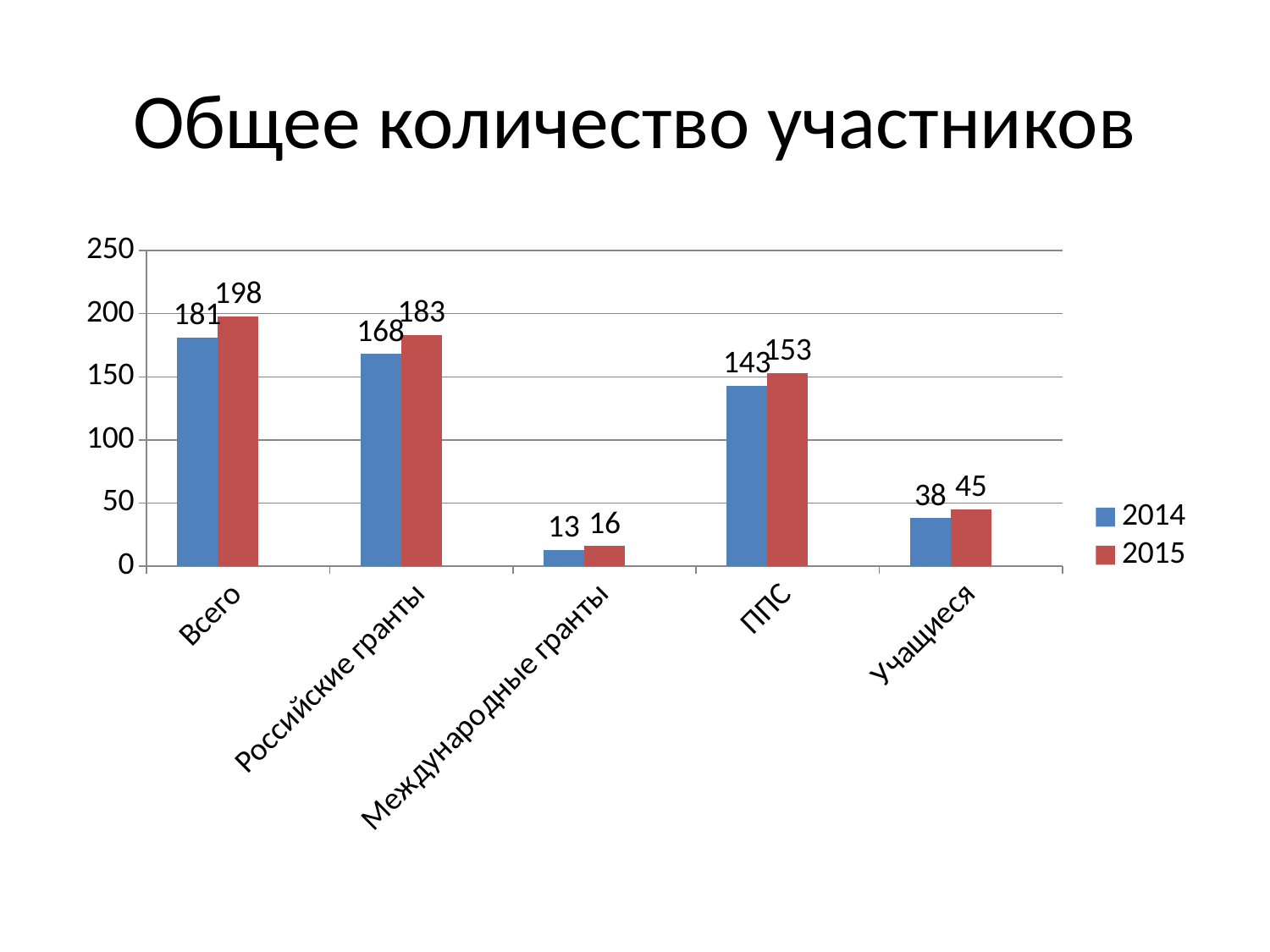
What is the difference between the 2015 and 2014 values for Всего? 17 How many categories are shown on the x axis? 5 What is the value for Международные гранты in 2014? 13 Which category has the lowest value in 2015? Международные гранты Which is larger for ППС: the 2014 value or the 2015 value? 2015 What is the difference between the 2015 and 2014 values for Российские гранты? 15 What type of chart is shown on the slide? Bar chart How many series does the legend list? 2 What is the value for Всего in 2015? 198 What is the value for Учащиеся in 2014? 38 What is the value for ППС in 2015? 153 Which category has the highest value in 2014? Всего